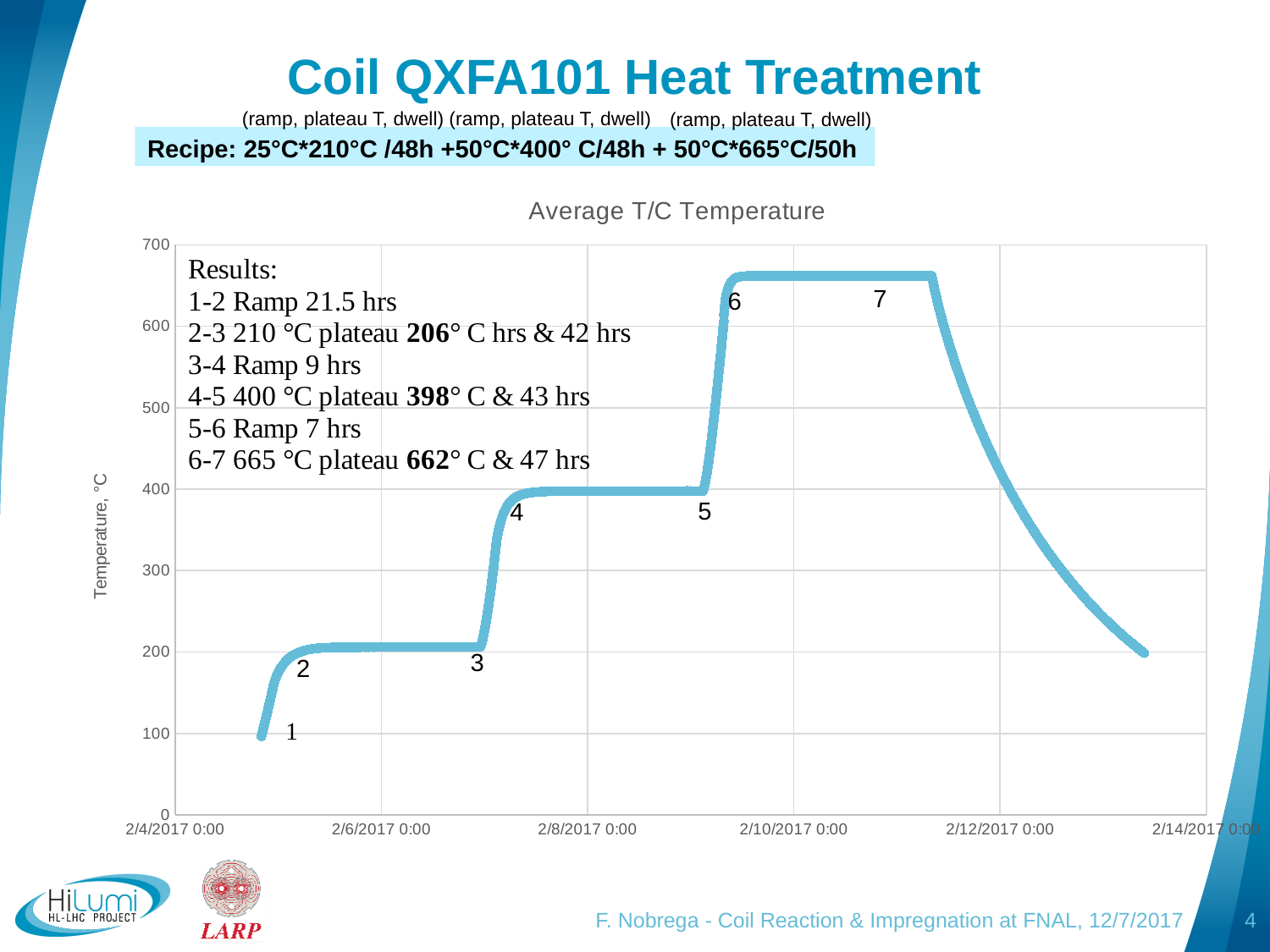
Does the temperature rise or fall along the curve from point 1 to point 7? rise Is the temperature at the plateau between points 6 and 7 greater or less than 600? greater Is the temperature at the plateau between points 2 and 3 greater or less than 300? less How many numbered points are marked on the temperature curve? 7 Is the temperature at point 1 greater or less than 200? less Which plateau is at a higher temperature, the one between points 2 and 3 or the one between points 6 and 7? between points 6 and 7 What is the title of the chart? Average T/C Temperature What is the label of the vertical axis of the chart? Temperature, °C What kind of chart is shown on the slide? line chart Does the temperature rise or fall after point 7? fall According to the results text on the chart, what measured temperature is given for the 400 °C plateau (points 4-5)? 398° C